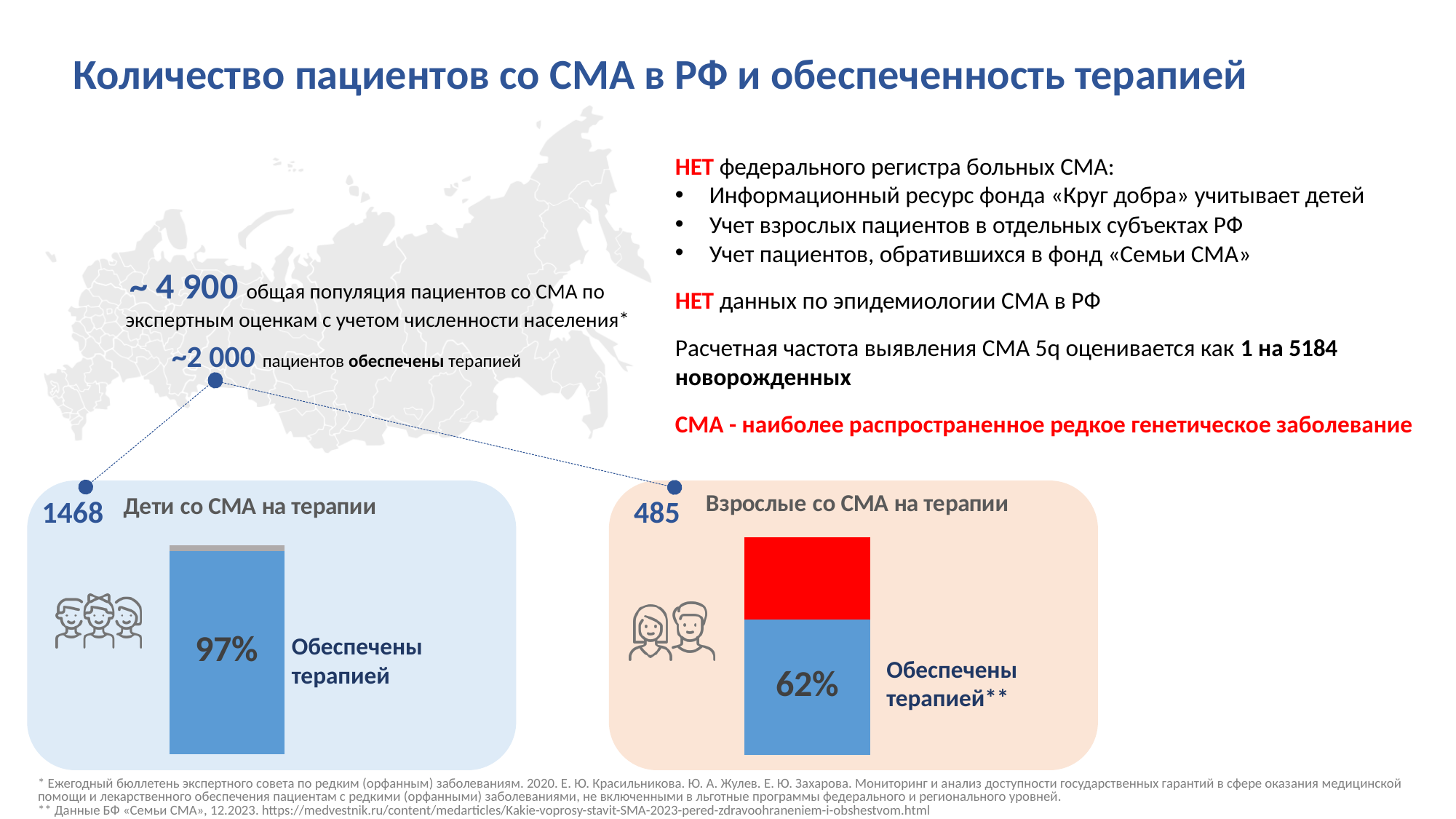
What number of adults on therapy is printed next to the title of the "Взрослые со СМА на терапии" chart? 485 What is the difference in percentage points between the share provided with therapy in the children's chart (97%) and the adults' chart (62%)? 35 percentage points What number of children on therapy is printed next to the title of the "Дети со СМА на терапии" chart? 1468 Which chart shows the higher share of patients provided with therapy: "Дети со СМА на терапии" or "Взрослые со СМА на терапии"? Дети со СМА на терапии In the chart titled "Взрослые со СМА на терапии", what percentage of adults are shown as provided with therapy ("Обеспечены терапией")? 62% In the "Взрослые со СМА на терапии" chart, what colour is the upper segment of the stacked bar? Red In the chart titled "Дети со СМА на терапии", what percentage of children are shown as provided with therapy ("Обеспечены терапией")? 97% What kind of chart is used in the "Взрослые со СМА на терапии" panel? Stacked bar chart How many bars are plotted in the "Взрослые со СМА на терапии" chart? 1 What kind of chart is used in the "Дети со СМА на терапии" panel? Stacked bar chart In the "Взрослые со СМА на терапии" chart, what colour is the segment representing patients provided with therapy (62%)? Blue How many bars are plotted in the "Дети со СМА на терапии" chart? 1